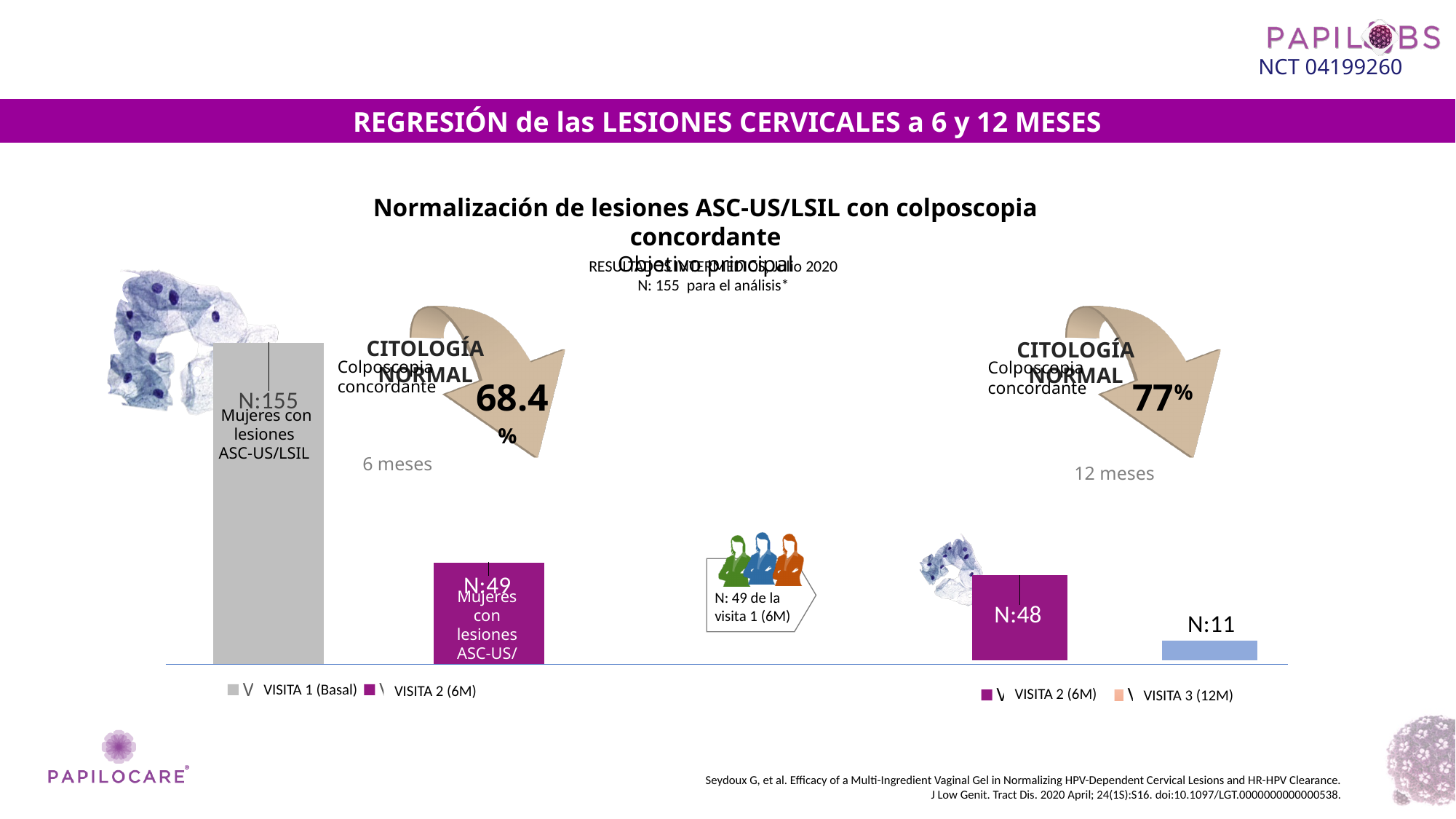
On the left chart, what is the value for VISITA 2 (6M)? N:49 What is the title shown above the charts? Normalización de lesiones ASC-US/LSIL con colposcopia concordante On the right chart, what is the difference between the VISITA 2 (6M) and VISITA 3 (12M) values? 37 Is the VISITA 2 (6M) value on the left chart larger or smaller than the VISITA 3 (12M) value on the right chart? larger On the right chart, what is the value for VISITA 2 (6M)? N:48 How many series does the legend of the right chart list? 2 On the left chart, what is the difference between the VISITA 1 (Basal) and VISITA 2 (6M) values? 106 What kind of chart is the left chart? bar chart On the left chart, which visit has the higher value? VISITA 1 (Basal) On the right chart, which visit has the lower value? VISITA 3 (12M) On the left chart, what is the value for VISITA 1 (Basal)? N:155 On the right chart, what is the value for VISITA 3 (12M)? N:11